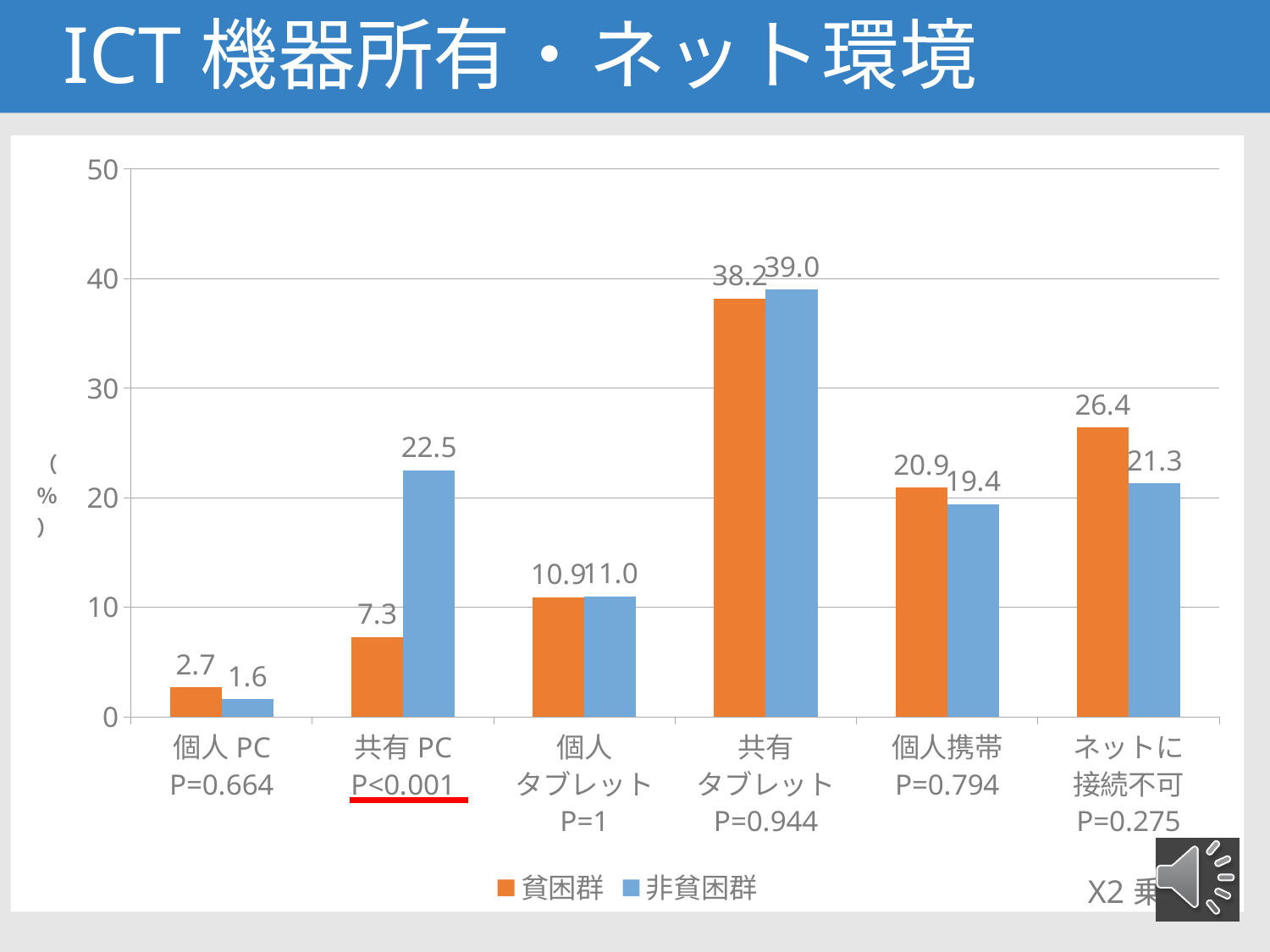
Is the value for 貧困群 in the 共有タブレット category greater or less than 30? greater What is the value for 貧困群 in the ネットに接続不可 category? 26.4 How many series does the legend list? 2 In the 個人携帯 category, which series has the larger value, 貧困群 or 非貧困群? 貧困群 How many categories are shown on the x axis? 6 What is the difference between 非貧困群 and 貧困群 in the 共有 PC category? 15.2 Which category has the highest value for 非貧困群? 共有タブレット Which category has the lowest value for 貧困群? 個人 PC What is the value for 非貧困群 in the 共有 PC category? 22.5 What kind of chart is shown on the slide? bar chart What is the value for 貧困群 in the 共有 PC category? 7.3 Which category has its P value underlined in red? 共有 PC